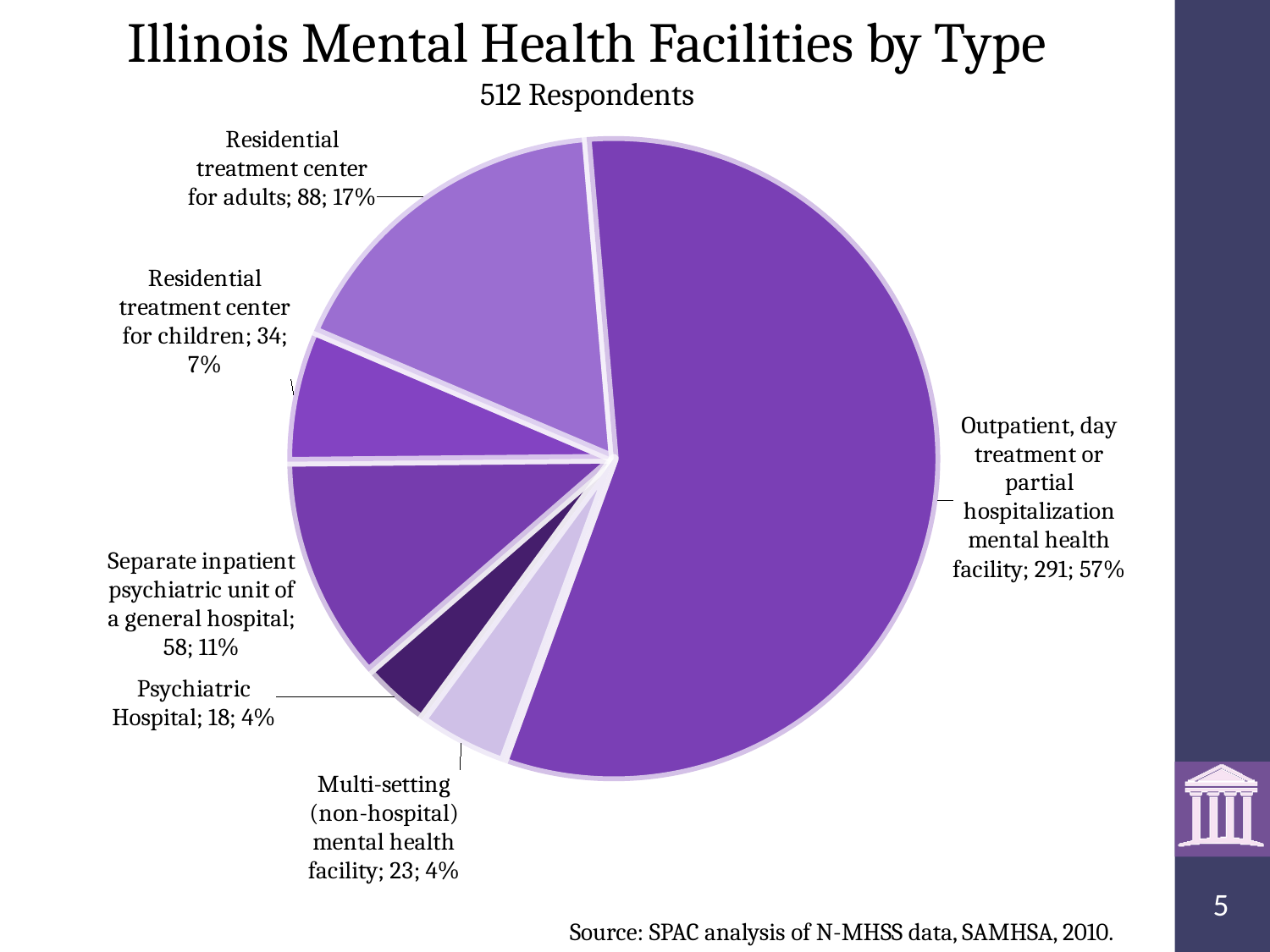
Which is larger: Separate inpatient psychiatric unit of a general hospital or Multi-setting (non-hospital) mental health facility? Separate inpatient psychiatric unit of a general hospital What percentage of the pie is the Separate inpatient psychiatric unit of a general hospital slice? 11% How many respondents does the chart subtitle report? 512 Respondents What share of the pie is the Residential treatment center for adults slice? 17% How many facilities are in the Psychiatric Hospital category? 18 What kind of chart is shown on the slide? pie chart What is the difference in count between Residential treatment center for adults and Residential treatment center for children? 54 How many categories does the pie chart show? 6 How many facilities are in the Outpatient, day treatment or partial hospitalization mental health facility category? 291 What is the title of the chart? Illinois Mental Health Facilities by Type Which category has the smallest slice of the pie? Psychiatric Hospital Which category has the largest slice of the pie? Outpatient, day treatment or partial hospitalization mental health facility